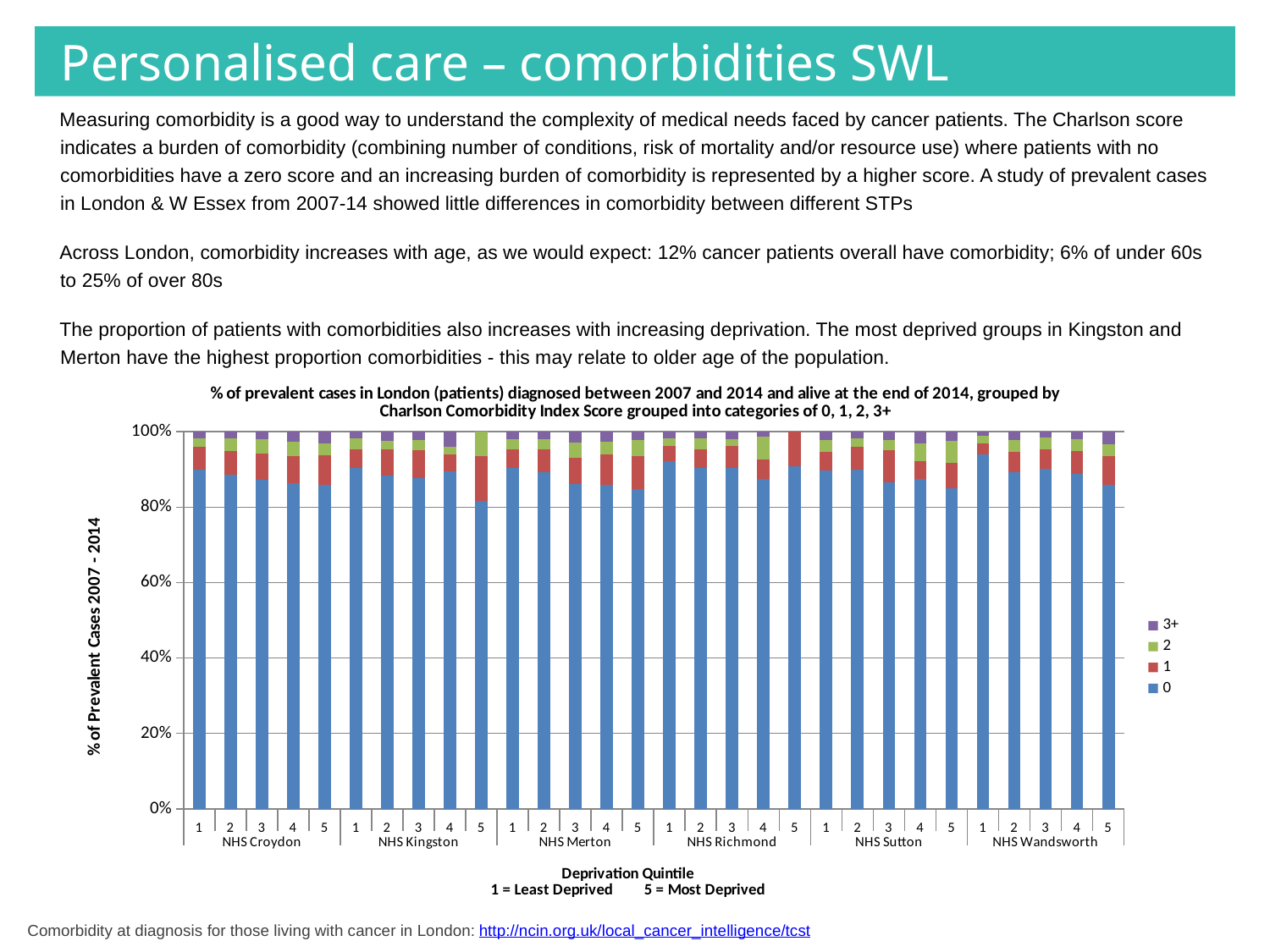
How many series does the chart legend list? 4 How many deprivation quintile bars are plotted for each NHS area? 5 What are the legend entries of the chart? 3+, 2, 1, 0 What is the label of the y axis of the chart? % of Prevalent Cases 2007 - 2014 Is the '0' comorbidity share for NHS Kingston deprivation quintile 5 greater or less than 60%? greater Is the '0' comorbidity share for NHS Wandsworth deprivation quintile 5 greater or less than 100%? less Which deprivation quintile is labelled as 'Most Deprived' on the x axis? 5 Is the '0' comorbidity share for NHS Croydon deprivation quintile 1 greater or less than 80%? greater How many bars are plotted in total on the chart? 30 What kind of chart is shown on the slide? Stacked bar chart How many NHS areas are shown along the x axis of the chart? 6